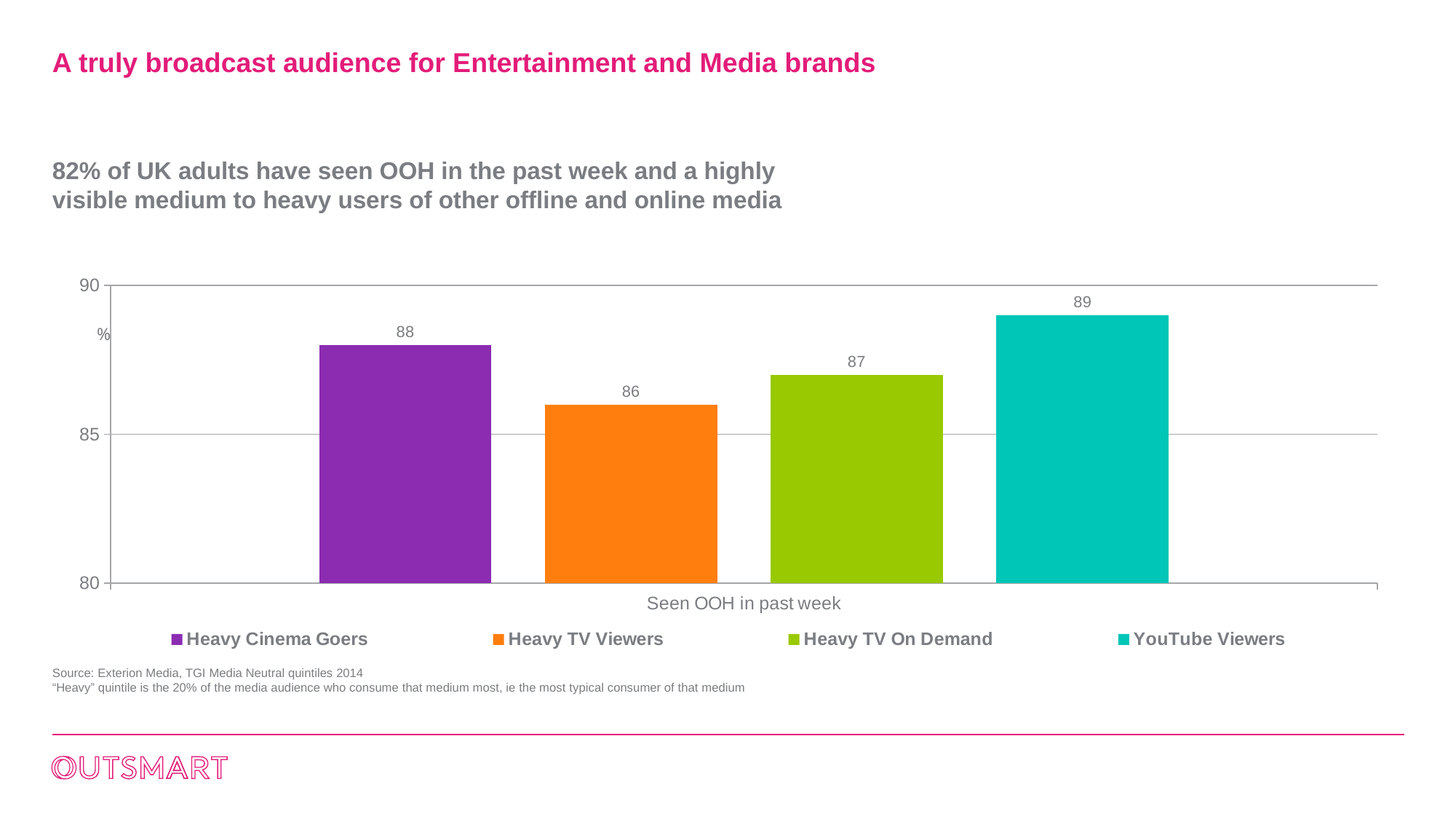
How many series does the legend list? 4 What is the value for Heavy TV On Demand? 87 Which is larger, the value for Heavy Cinema Goers or the value for Heavy TV On Demand? Heavy Cinema Goers Which series has the lowest value? Heavy TV Viewers Which series has the highest value? YouTube Viewers What is the x-axis category label under the bars? Seen OOH in past week Is the value for Heavy TV Viewers greater or less than 85? greater What is the value for Heavy TV Viewers? 86 What kind of chart is shown on the slide? bar chart What is the value for Heavy Cinema Goers? 88 What is the value for YouTube Viewers? 89 What is the difference between the values for YouTube Viewers and Heavy TV Viewers? 3